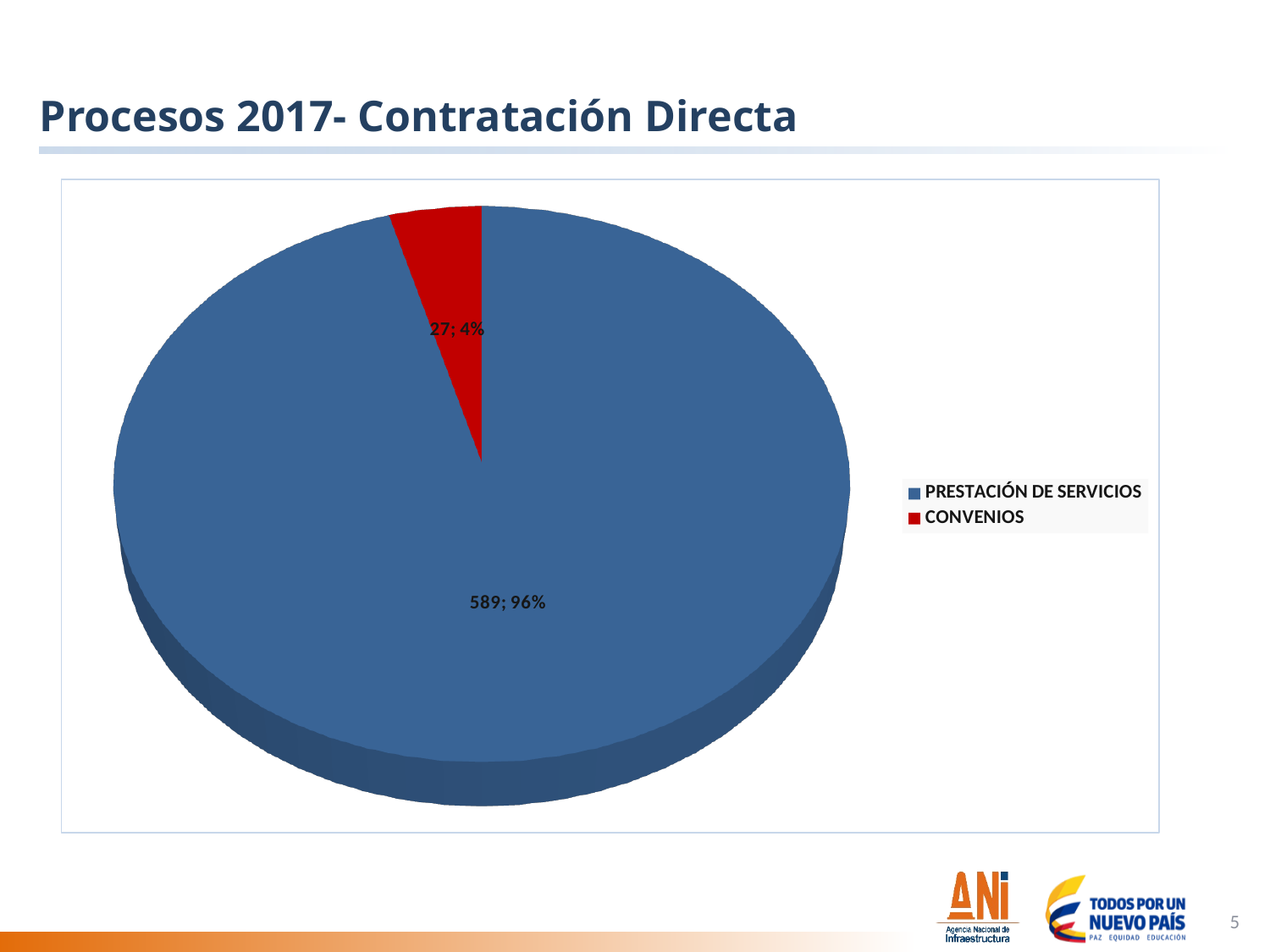
What is the value for CONVENIOS? 27 What share of the pie does CONVENIOS represent? 4% Which category has the smallest slice? CONVENIOS What colour is the CONVENIOS slice? red Which is larger, PRESTACIÓN DE SERVICIOS or CONVENIOS? PRESTACIÓN DE SERVICIOS What is the difference between the values for PRESTACIÓN DE SERVICIOS and CONVENIOS? 562 What is the value for PRESTACIÓN DE SERVICIOS? 589 How many categories does the pie chart have? 2 Which category has the largest slice? PRESTACIÓN DE SERVICIOS What is the total of the two slices? 616 What kind of chart is shown on the slide? pie chart What share of the pie does PRESTACIÓN DE SERVICIOS represent? 96%